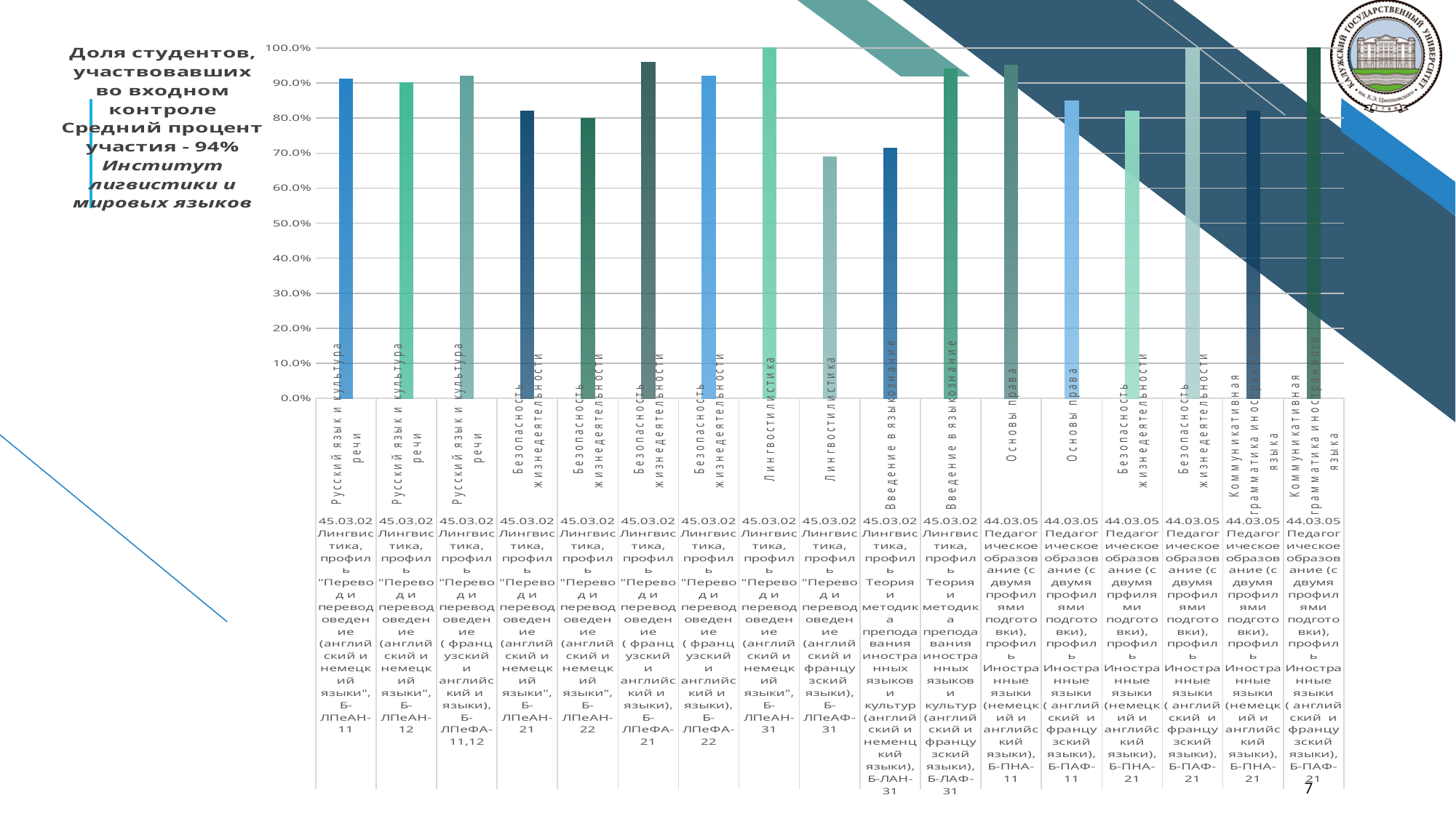
Is the value for Введение в языкознание, group Б-ЛАН-31, greater or less than 80%? less What is the highest value shown on the vertical axis of the chart? 100.0% Is the value for Лингвостилистика, group Б-ЛПеАФ-31, greater or less than 80%? less Which is larger: the value for Основы права for group Б-ПНА-11 or for group Б-ПАФ-11? Б-ПНА-11 According to the text on the slide, what is the average participation percentage (средний процент участия)? 94% Is the value for Русский язык и культура речи, group Б-ЛПеАН-11, greater or less than 80%? greater Which is larger: the value for Безопасность жизнедеятельности for group Б-ЛПеАН-21 or for group Б-ЛПеФА-21? Б-ЛПеФА-21 How many bars (categories) are plotted in the chart? 17 What kind of chart is shown on the slide? bar chart What is the value for Безопасность жизнедеятельности, group Б-ПАФ-21? 100.0% What is the value for Лингвостилистика, group Б-ЛПеАН-31? 100.0%